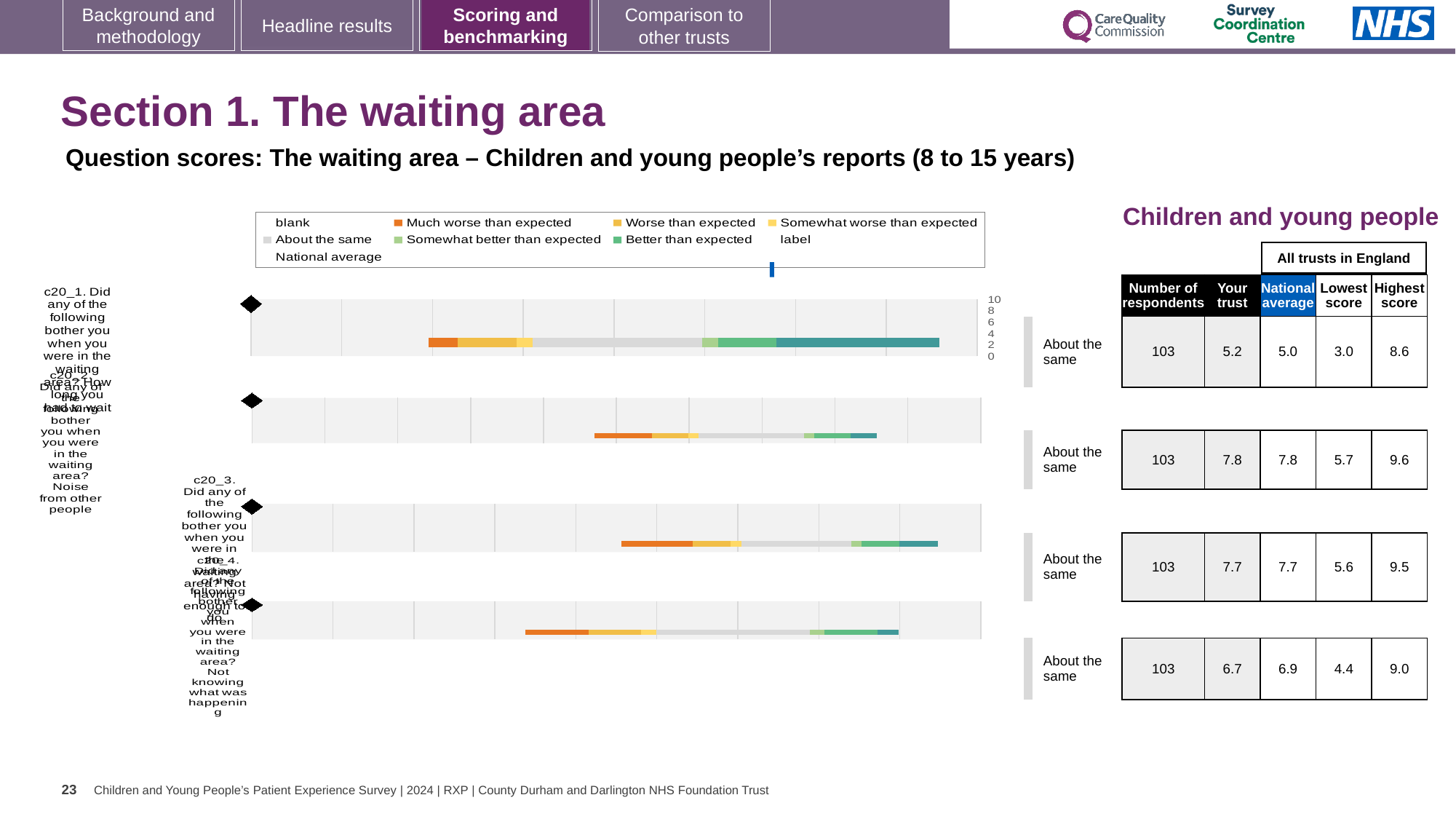
What colour represents 'Better than expected' in the legend? teal Which chart has the highest 'Your trust' score? the second chart from the top (7.8) What kind of chart is used to show the question scores on this slide? bar chart For the second chart from the top, what is the national average score? 7.8 How many separate bar charts are shown on the slide? 4 What is the number of respondents for the top chart? 103 For the top chart, what is the difference between the highest score and the lowest score? 5.6 For the bottom chart, which is larger: the 'Your trust' score or the national average? National average What benchmark label is shown to the right of each of the four charts? About the same What colour represents 'Much worse than expected' in the legend? orange How many entries does the legend above the charts list? 9 For the top chart (c20_1), what is the 'Your trust' score shown in the table? 5.2